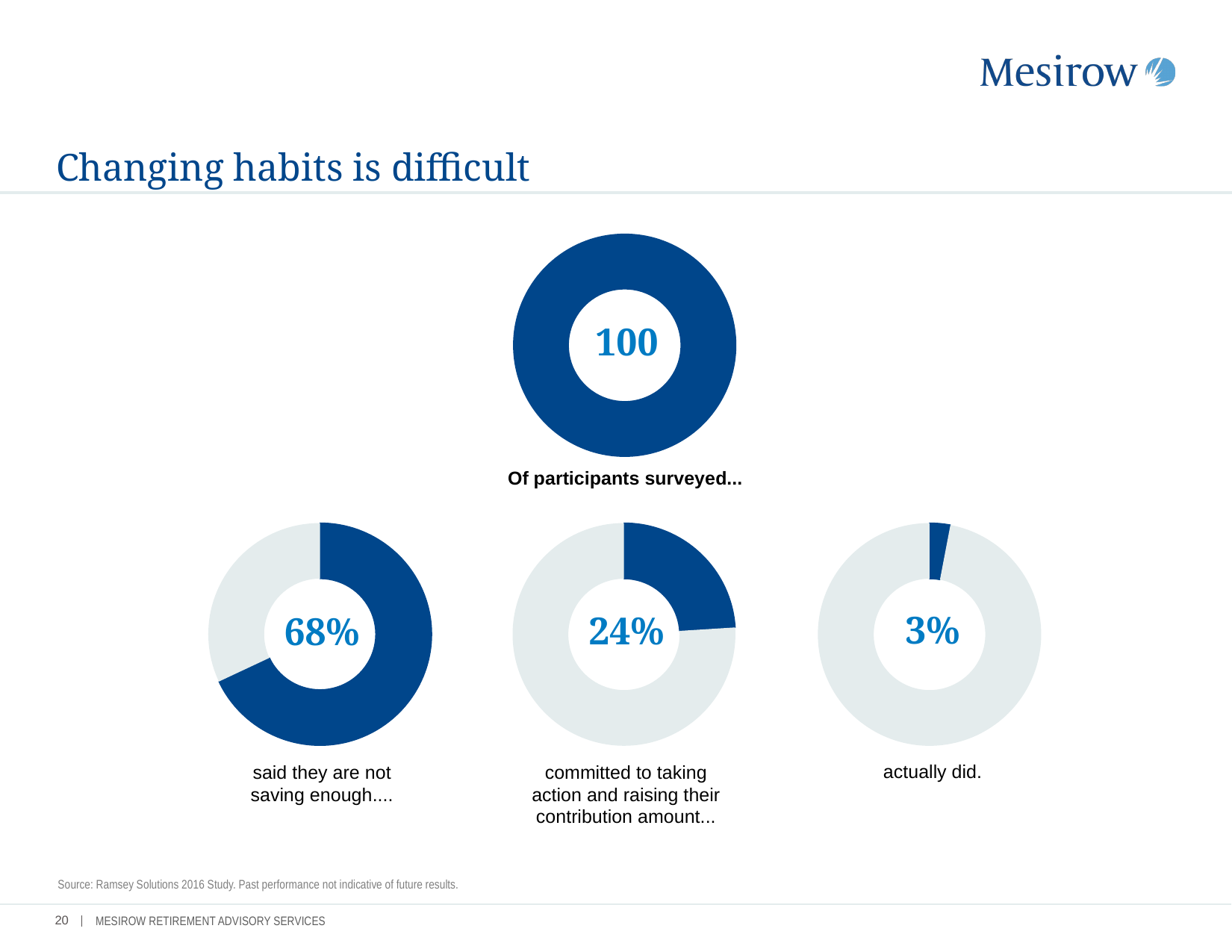
What is the difference between the percentage who said they are not saving enough and the percentage who committed to taking action? 44% Among the three bottom donut charts, which has the highest percentage? said they are not saving enough (68%) What kind of charts are used on this slide? Donut charts Which is larger: the percentage who committed to taking action or the percentage who actually did? committed to taking action (24%) How many donut charts are shown on the slide? 4 What percentage of participants committed to taking action and raising their contribution amount? 24% Among the three bottom donut charts, which has the lowest percentage? actually did (3%) What number is shown in the centre of the top donut chart labelled 'Of participants surveyed...'? 100 What is the difference between the percentage who committed to taking action and the percentage who actually did? 21% What percentage of participants said they are not saving enough? 68% What percentage of participants actually did raise their contribution amount? 3% What is the title of the slide containing these donut charts? Changing habits is difficult